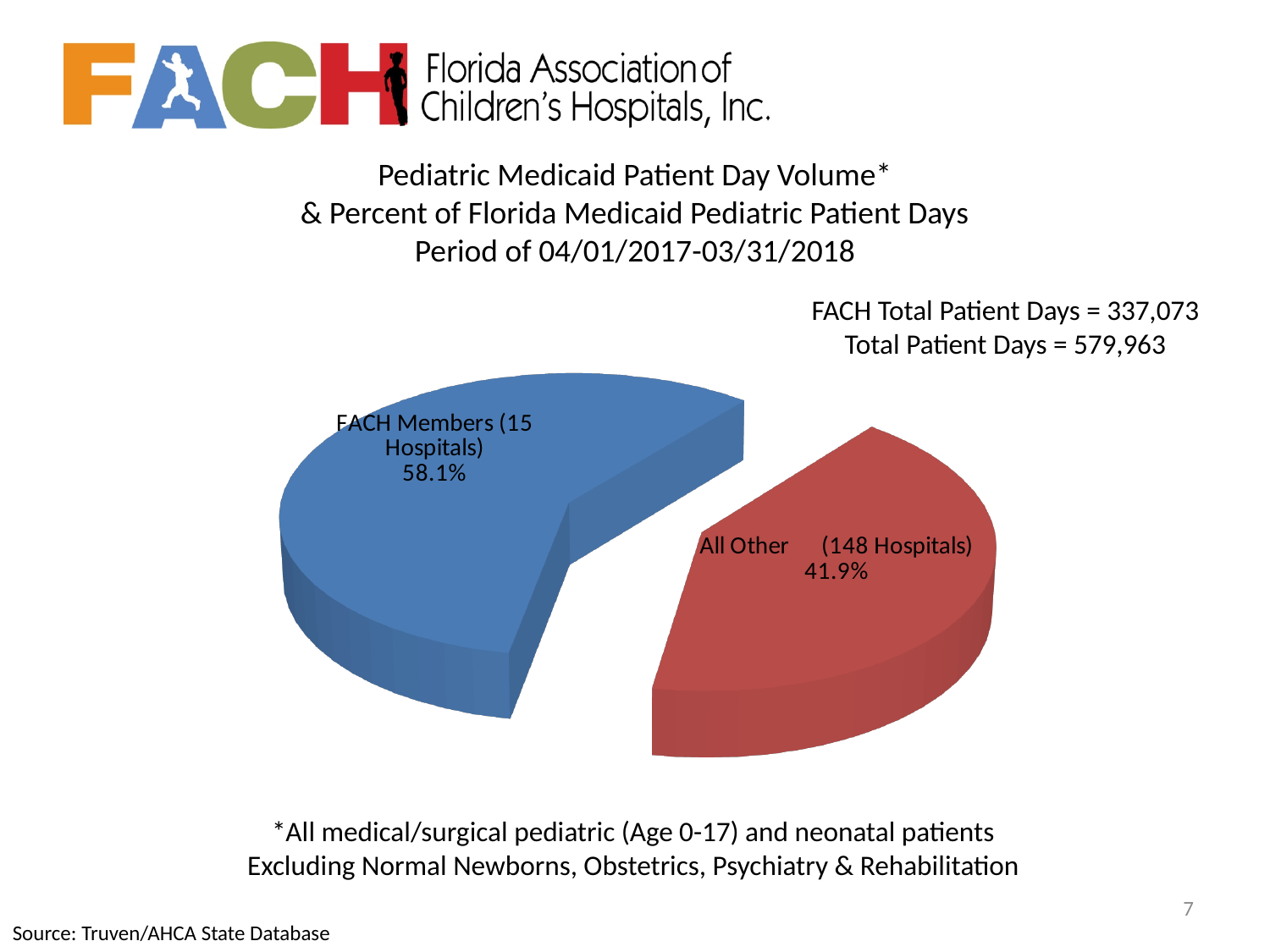
What colour is the FACH Members slice of the pie chart? Blue How many slices does the pie chart have? 2 What percentage of Florida Medicaid pediatric patient days is attributed to All Other (148 Hospitals)? 41.9% Which is larger, the share for FACH Members or the share for All Other? FACH Members What is the difference in percentage points between the FACH Members slice and the All Other slice? 16.2 percentage points How many hospitals are included in the All Other slice? 148 Hospitals What type of chart is shown on the slide? Pie chart What is the Total Patient Days figure stated on the slide? 579,963 What percentage of Florida Medicaid pediatric patient days is attributed to FACH Members (15 Hospitals)? 58.1% What is the FACH Total Patient Days figure stated on the slide? 337,073 Which slice of the pie chart is the smallest? All Other (148 Hospitals) Which slice of the pie chart is the largest? FACH Members (15 Hospitals)